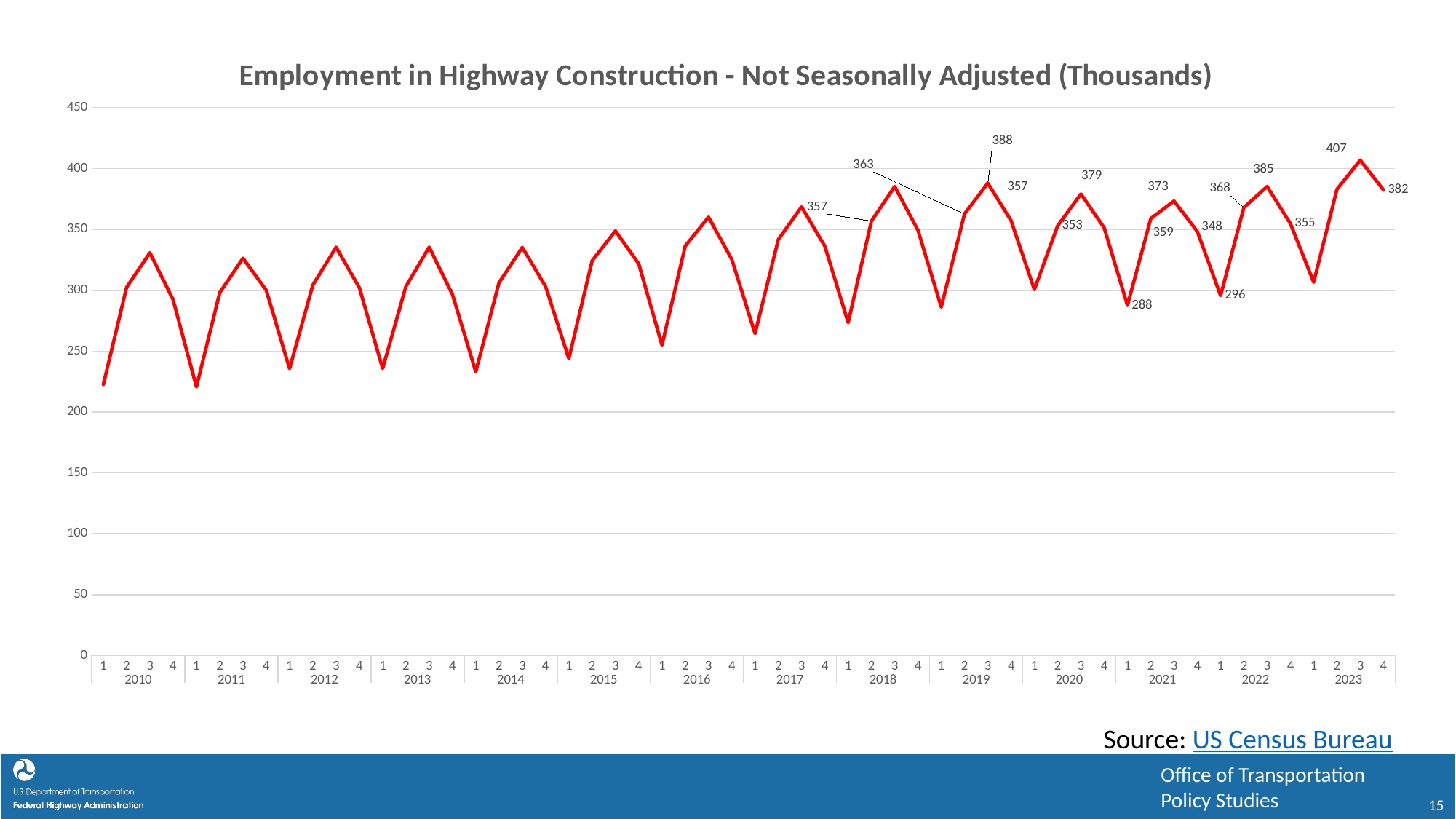
What kind of chart is shown on the slide? Line chart Do the annual peak values generally rise or fall from 2010 to 2023? Rise What is the value for quarter 3 of 2023? 407 What is the difference between the values for quarter 3 of 2022 and quarter 3 of 2021? 12 What is the difference between the values for quarter 3 and quarter 4 of 2023? 25 Is the value for quarter 3 of 2016 greater or less than 350? greater What is the value for quarter 1 of 2021? 288 What is the value for quarter 3 of 2019? 388 What is the value for quarter 4 of 2022? 355 Is the value for quarter 1 of 2010 greater or less than 250? less Which quarter has the highest value on the chart? Quarter 3 of 2023 Which is larger, the value for quarter 3 of 2020 or quarter 3 of 2022? Quarter 3 of 2022